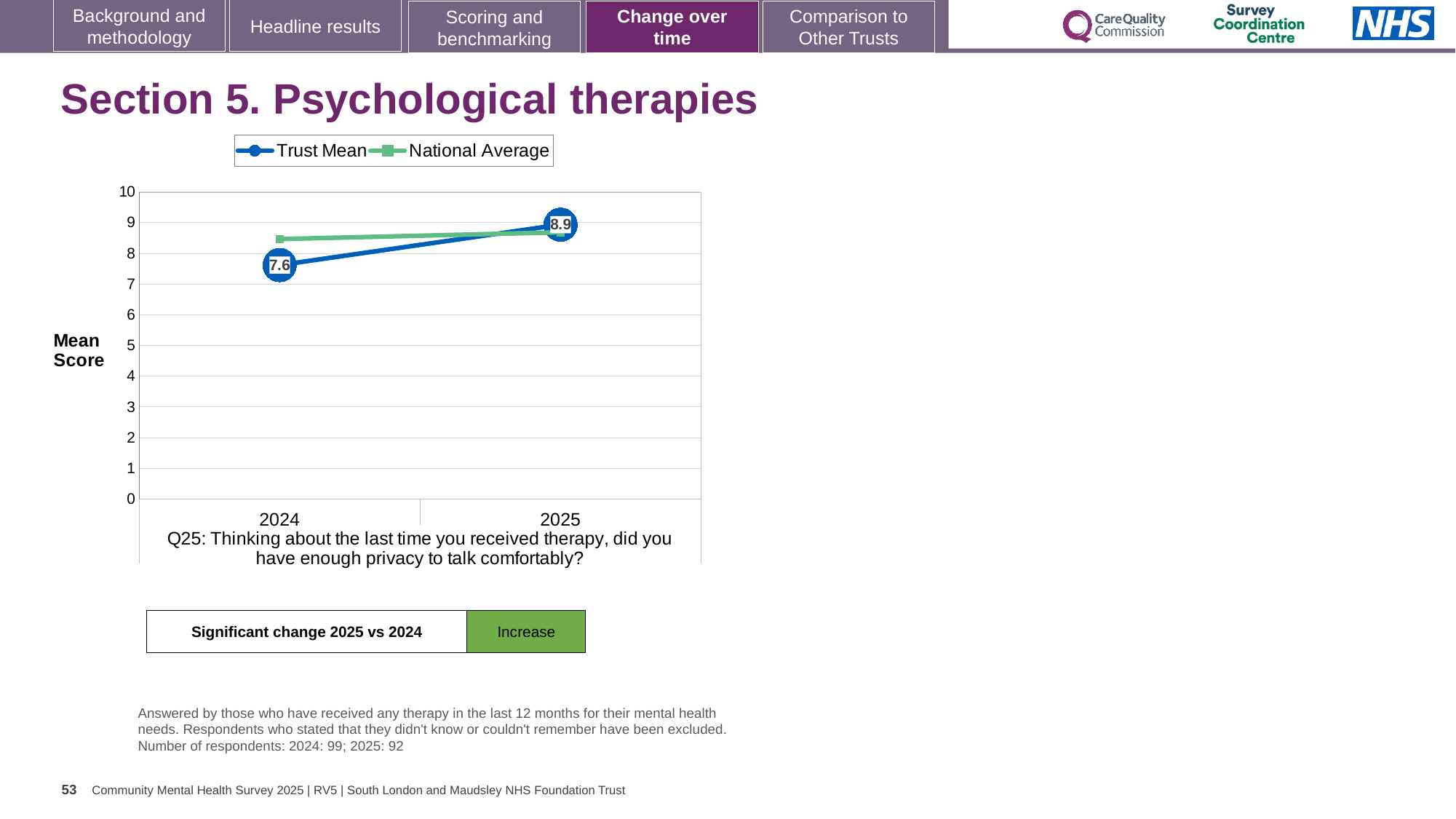
How many series does the legend list? 2 What is the label on the y axis of the chart? Mean Score What is the Trust Mean score for 2024? 7.6 Is the National Average value for 2024 greater or less than 8? greater In 2024, which is larger: the Trust Mean or the National Average? National Average Does the Trust Mean rise or fall from 2024 to 2025? rise What is the Trust Mean score for 2025? 8.9 What kind of chart is shown on the slide? line chart In which year is the Trust Mean highest? 2025 By how much did the Trust Mean score change from 2024 to 2025? 1.3 How many years are plotted on the x axis? 2 Is the National Average value for 2025 greater or less than 9? less